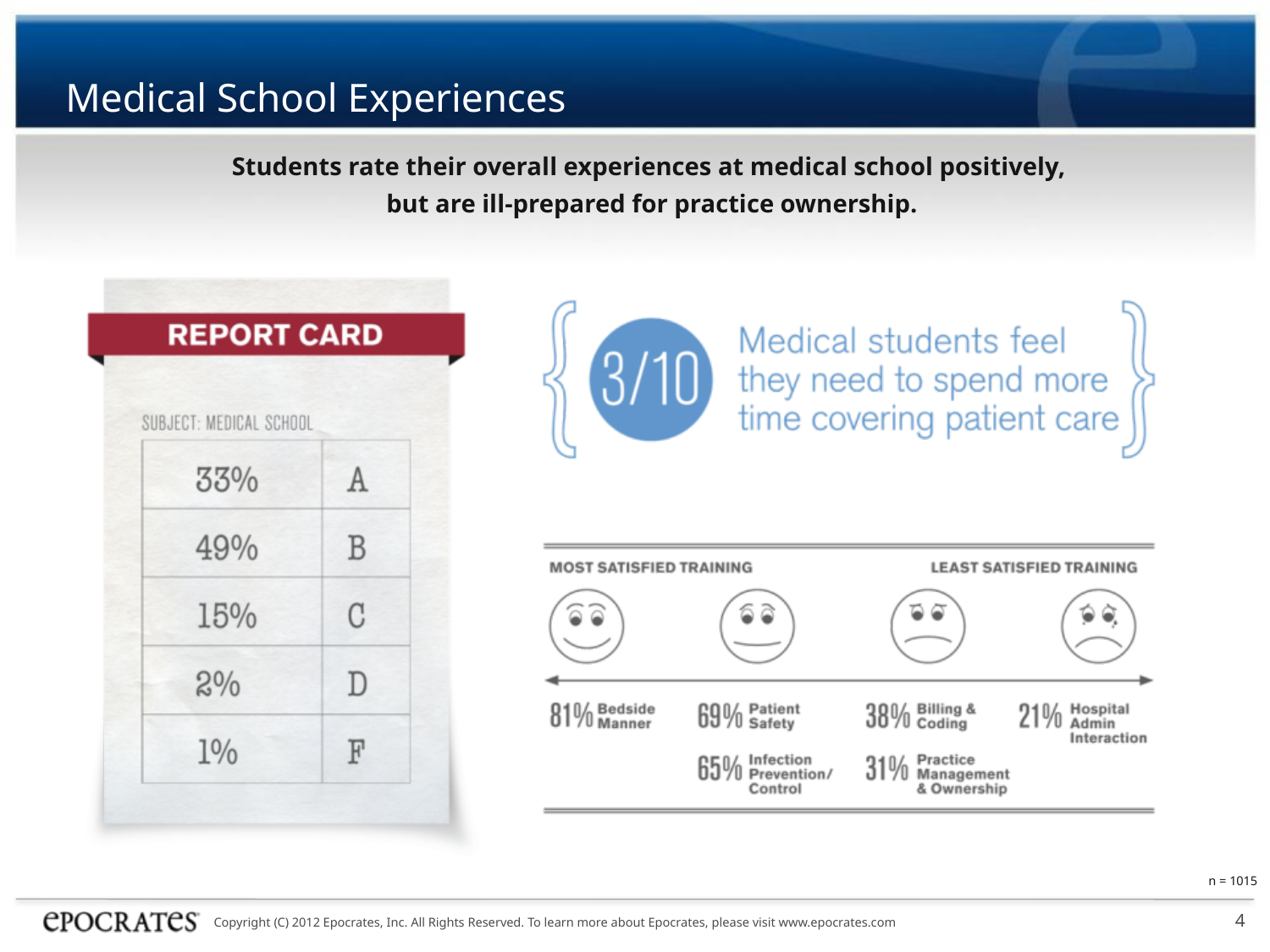
On the Report Card graphic, how many grade categories are listed? 5 On the Report Card graphic, what percentage of students gave medical school a grade of B? 49% On the training satisfaction graphic, what percentage is shown for Bedside Manner? 81% On the Report Card graphic, what percentage of students gave medical school a grade of A? 33% According to the circle graphic, what fraction of medical students feel they need to spend more time covering patient care? 3/10 On the training satisfaction graphic, what percentage is shown for Hospital Admin Interaction? 21% On the Report Card graphic, which grade has the highest percentage? B On the Report Card graphic, which grade has the lowest percentage? F On the training satisfaction graphic, which is larger: the percentage for Patient Safety or for Infection Prevention/Control? Patient Safety On the training satisfaction graphic, what is the difference between the percentages for Billing & Coding and Practice Management & Ownership? 7% On the Report Card graphic, what is the difference between the percentages for grade B and grade A? 16% On the training satisfaction graphic, which training area has the lowest satisfaction percentage? Hospital Admin Interaction